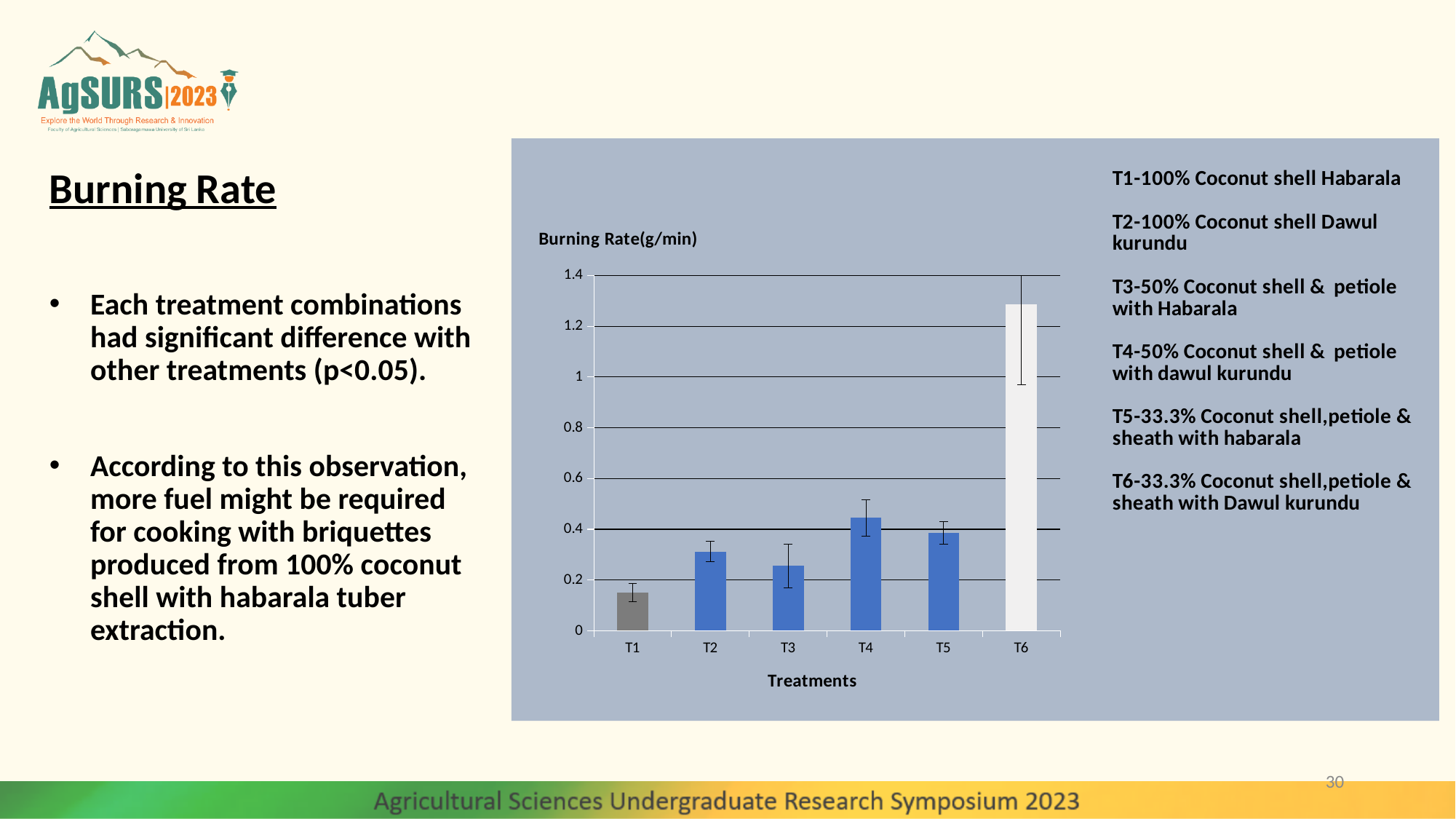
Is the burning rate for T1 greater or less than 0.2? less Is the burning rate for T4 greater or less than 0.4? greater Which treatment has the lowest burning rate? T1 How many treatments are plotted on the x axis of the chart? 6 What is the label of the x axis of the chart? Treatments Is the burning rate for T3 greater or less than 0.4? less Which has a higher burning rate, T3 or T4? T4 Which treatment has the highest burning rate? T6 Which has a higher burning rate, T4 or T5? T4 What kind of chart is shown on the slide? Bar chart